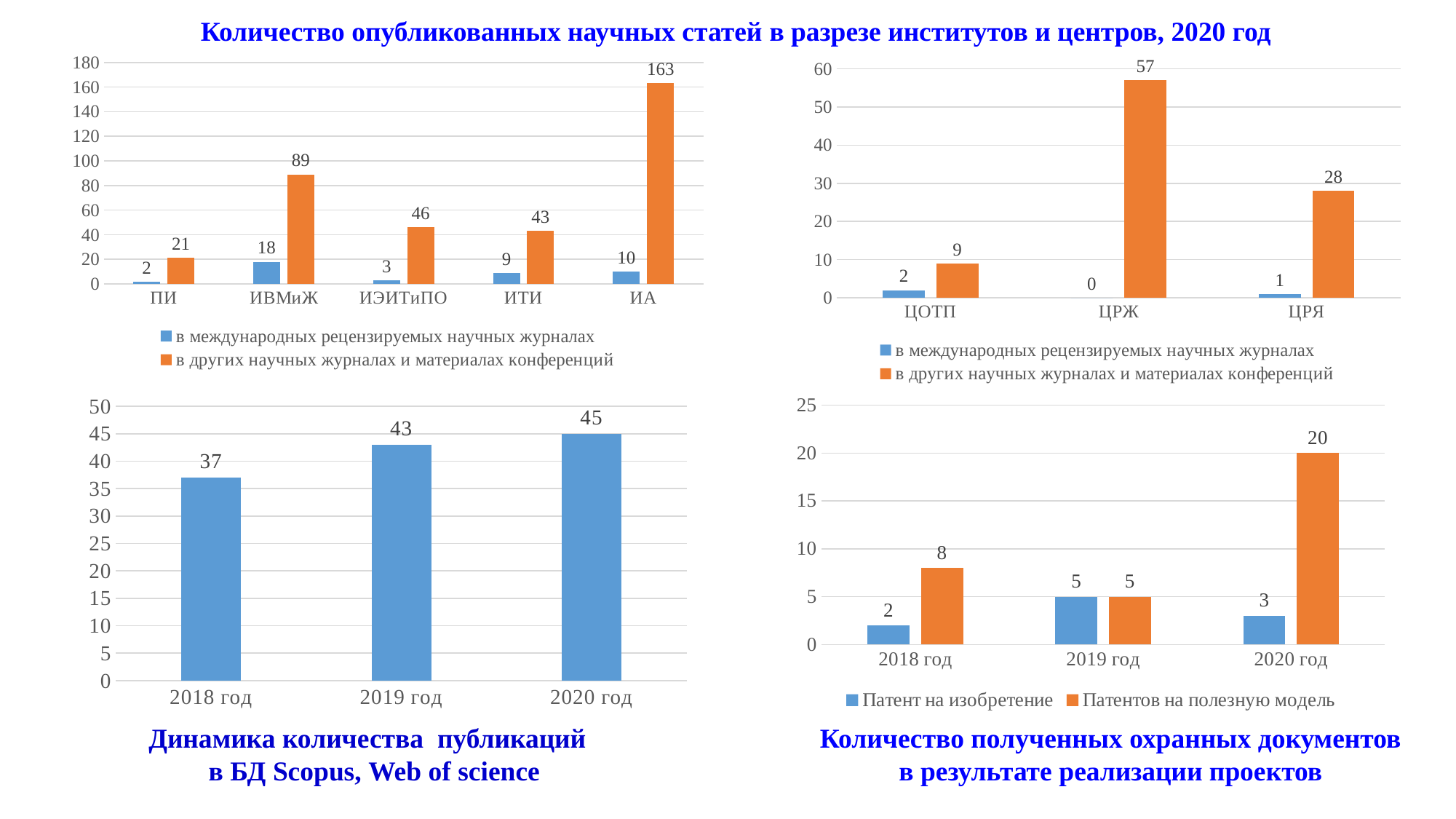
In the top-left chart, what is the value for ИА in the series 'в других научных журналах и материалах конференций'? 163 In the bottom-left chart 'Динамика количества публикаций в БД Scopus, Web of science', do the values rise or fall from 2018 год to 2020 год? rise In the top-right chart, what is the value for ЦРЖ in the series 'в других научных журналах и материалах конференций'? 57 In the top-left chart, what is the difference between the two series values for ИВМиЖ? 71 How many categories are shown on the x axis of the top-left chart? 5 In the bottom-left chart 'Динамика количества публикаций в БД Scopus, Web of science', what is the value for 2019 год? 43 In the top-right chart, which category has the lowest value for 'в международных рецензируемых научных журналах'? ЦРЖ How many series does the legend of the top-right chart list? 2 In the bottom-right chart 'Количество полученных охранных документов в результате реализации проектов', what is the value for 'Патентов на полезную модель' in 2020 год? 20 In the top-left chart, which category has the highest value for 'в международных рецензируемых научных журналах'? ИВМиЖ What kind of chart is the bottom-left chart 'Динамика количества публикаций в БД Scopus, Web of science'? bar chart In the bottom-right chart 'Количество полученных охранных документов в результате реализации проектов', which is larger in 2018 год: 'Патент на изобретение' or 'Патентов на полезную модель'? Патентов на полезную модель